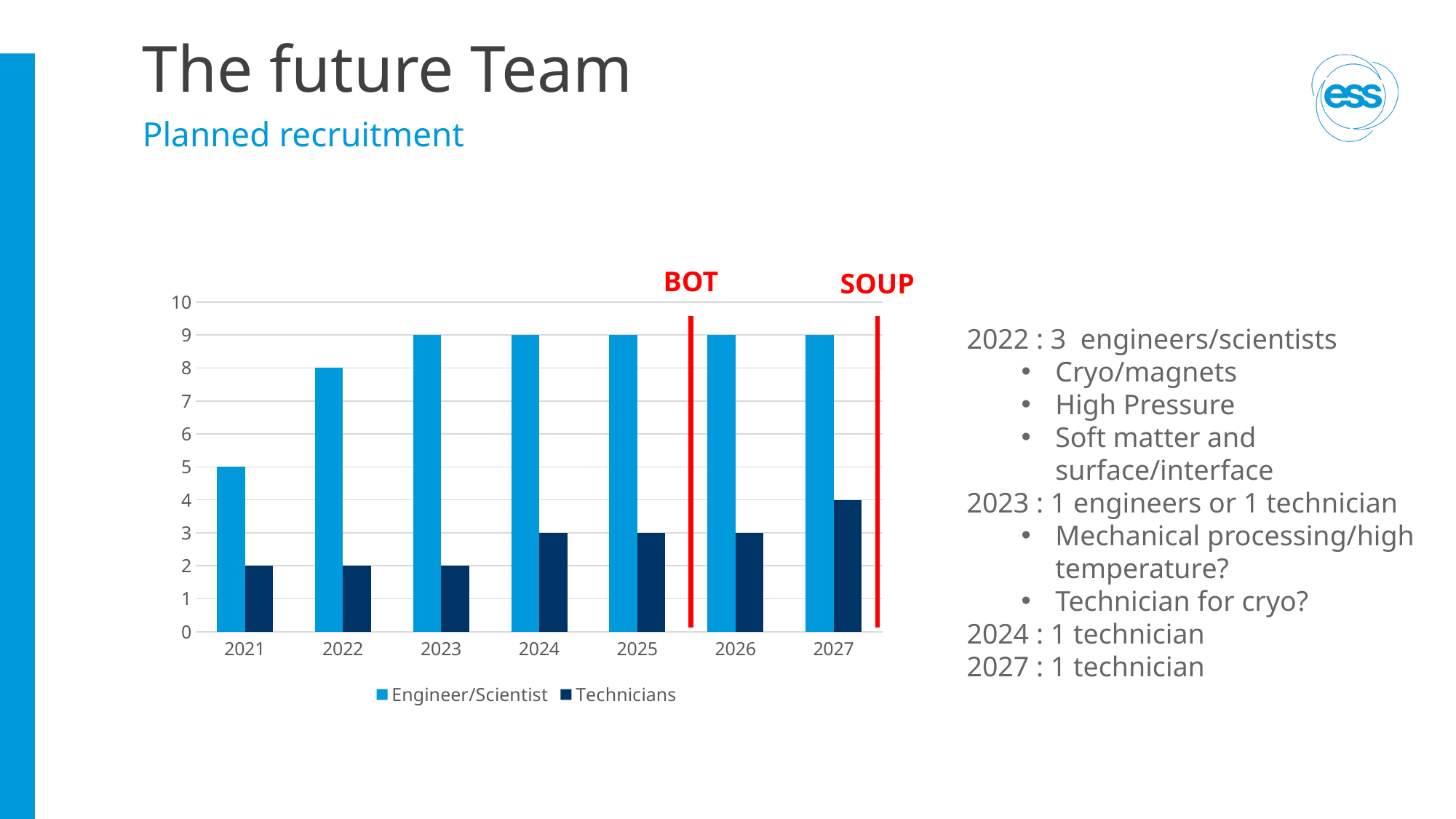
What is the difference between the Engineer/Scientist and Technicians values in 2021? 3 What kind of chart is shown on the slide? bar chart How many years are shown on the x axis of the chart? 7 Which year has the lowest Engineer/Scientist value? 2021 What is the Technicians value for 2024? 3 Which year has the highest Technicians value? 2027 Do the Technicians values rise or fall from 2021 to 2027? rise What is the Technicians value for 2027? 4 What is the Engineer/Scientist value for 2021? 5 How many series does the chart legend list? 2 Which is larger in 2022, the Engineer/Scientist value or the Technicians value? Engineer/Scientist What is the Engineer/Scientist value for 2022? 8